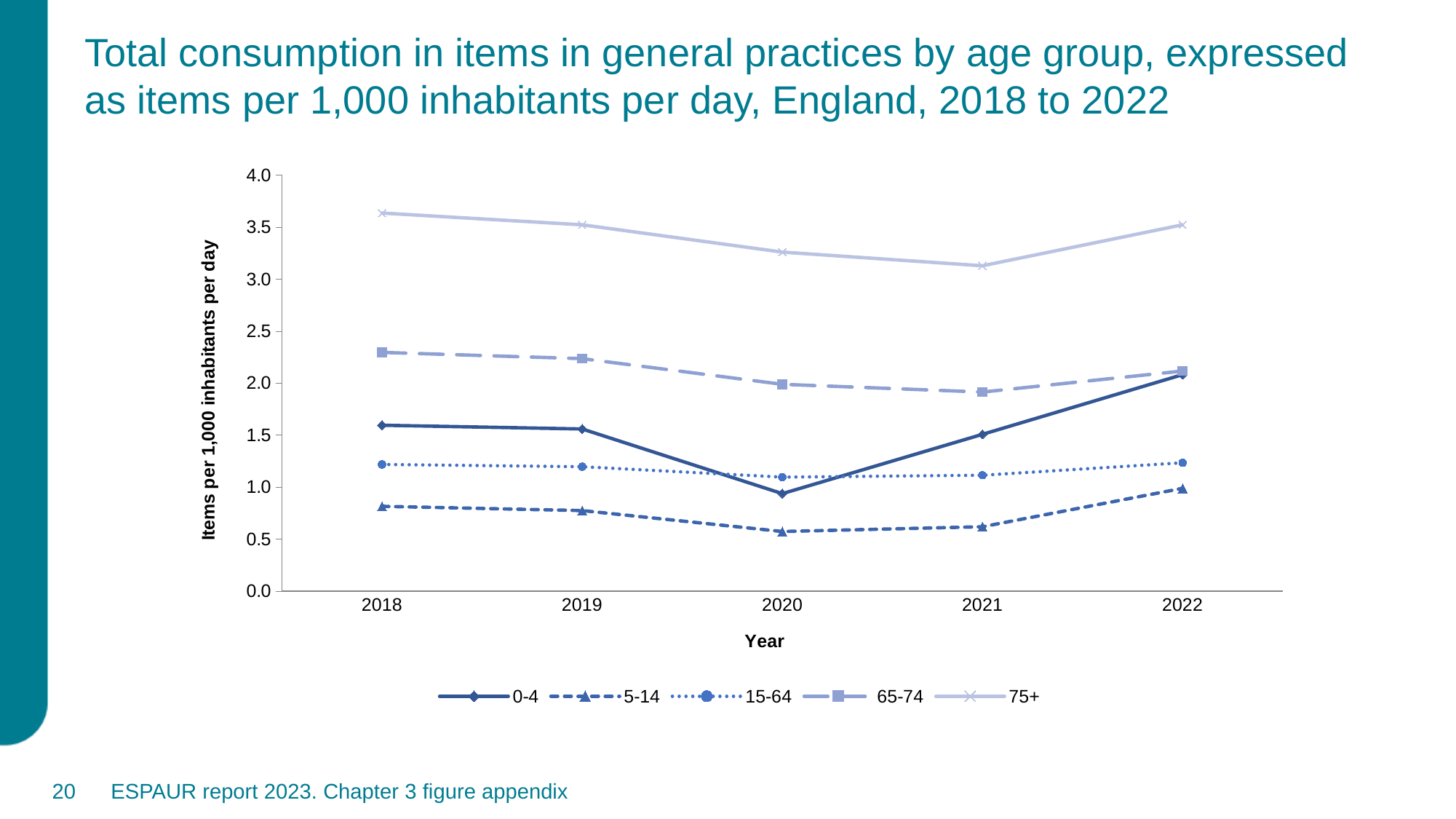
Is the value for the 65-74 age group in 2018 greater or less than 2.0? greater Which age group has the highest value in 2022? 75+ How many years are shown on the x axis? 5 Which age group has the lowest value in 2020? 5-14 How many age groups does the legend list? 5 In which year is the value for the 0-4 age group lowest? 2020 Is the value for the 5-14 age group in 2020 greater or less than 1.0? less Is the value for the 75+ age group in 2018 greater or less than 3.5? greater What kind of chart is shown on the slide? line chart In 2020, which is larger: the value for the 0-4 age group or the 15-64 age group? 15-64 Does the value for the 75+ age group rise or fall from 2018 to 2021? fall